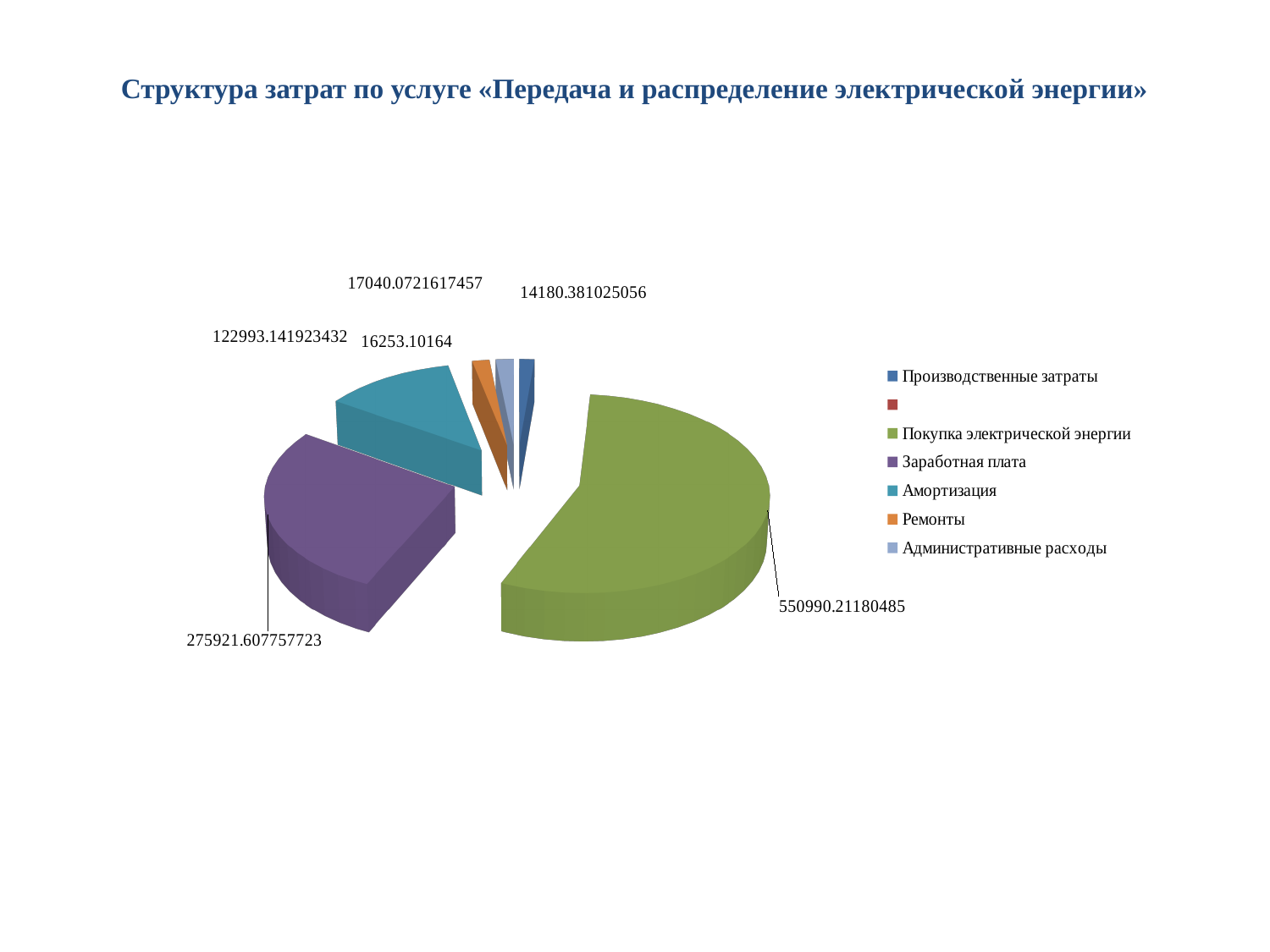
What is the value of the Амортизация slice? 122993.141923432 What is the value of the Покупка электрической энергии slice? 550990.21180485 How many named categories does the legend list? 6 What kind of chart is shown on the slide? Pie chart What colour is the Покупка электрической энергии slice? Green What is the value of the Заработная плата slice? 275921.607757723 How many slices with data labels does the pie chart have? 6 Which category has the largest slice of the pie? Покупка электрической энергии Which is larger, Заработная плата or Амортизация? Заработная плата What is the title of the chart? Структура затрат по услуге «Передача и распределение электрической энергии» What is the value of the Ремонты slice? 16253.10164 What is the difference between the Покупка электрической энергии value and the Заработная плата value? 275068.604047127